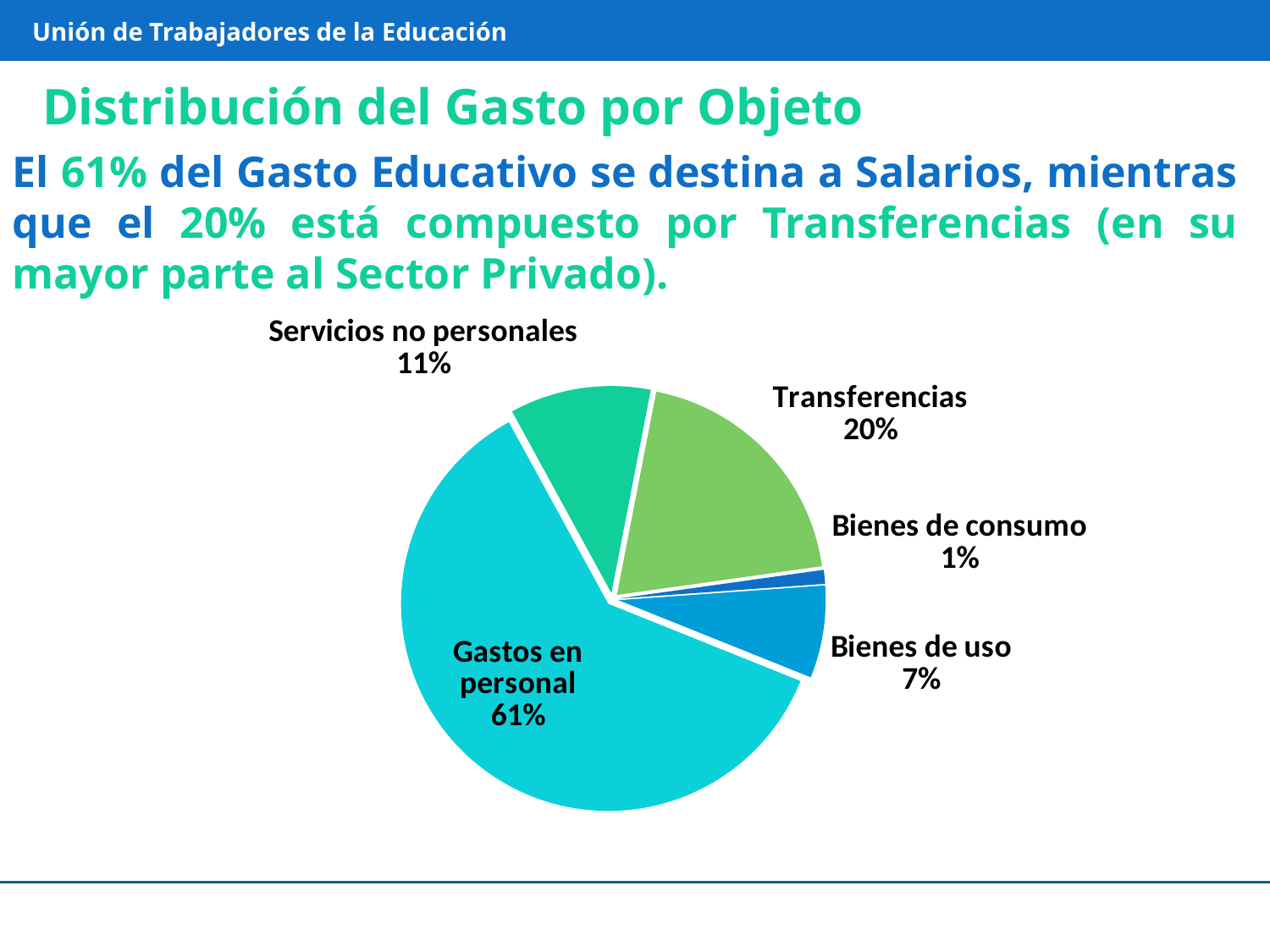
Which category has the smallest share of the pie? Bienes de consumo Which category has the largest share of the pie? Gastos en personal Which is larger, Servicios no personales or Bienes de uso? Servicios no personales How many categories are shown in the pie chart? 5 What percentage is shown for Transferencias? 20% What percentage is shown for Bienes de consumo? 1% What is the difference in percentage points between Gastos en personal and Transferencias? 41 What kind of chart is shown on the slide? pie chart What is the title of the slide containing the chart? Distribución del Gasto por Objeto What percentage is shown for Bienes de uso? 7% What share of the pie does Gastos en personal represent? 61% What percentage is shown for Servicios no personales? 11%